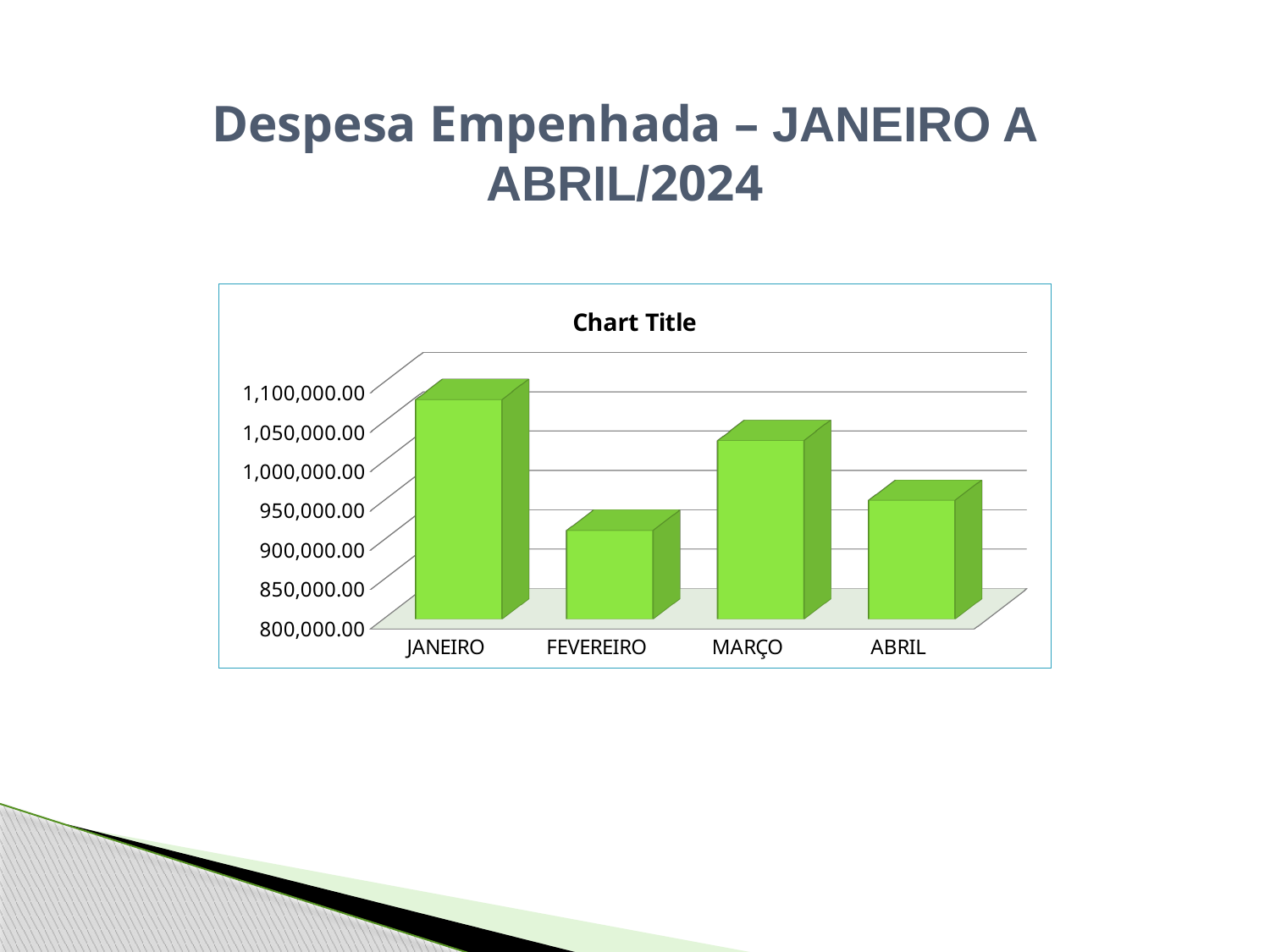
Which month has the highest value in the chart? JANEIRO Does the value rise or fall from JANEIRO to FEVEREIRO? fall How many categories (months) are plotted in the chart? 4 Which is larger, the value for ABRIL or the value for FEVEREIRO? ABRIL Is the value for JANEIRO greater or less than 1,050,000.00? greater Is the value for ABRIL greater or less than 1,000,000.00? less Which month has the lowest value in the chart? FEVEREIRO What kind of chart is shown on the slide? bar chart Is the value for FEVEREIRO greater or less than 950,000.00? less Which is larger, the value for JANEIRO or the value for MARÇO? JANEIRO Which is larger, the value for MARÇO or the value for ABRIL? MARÇO